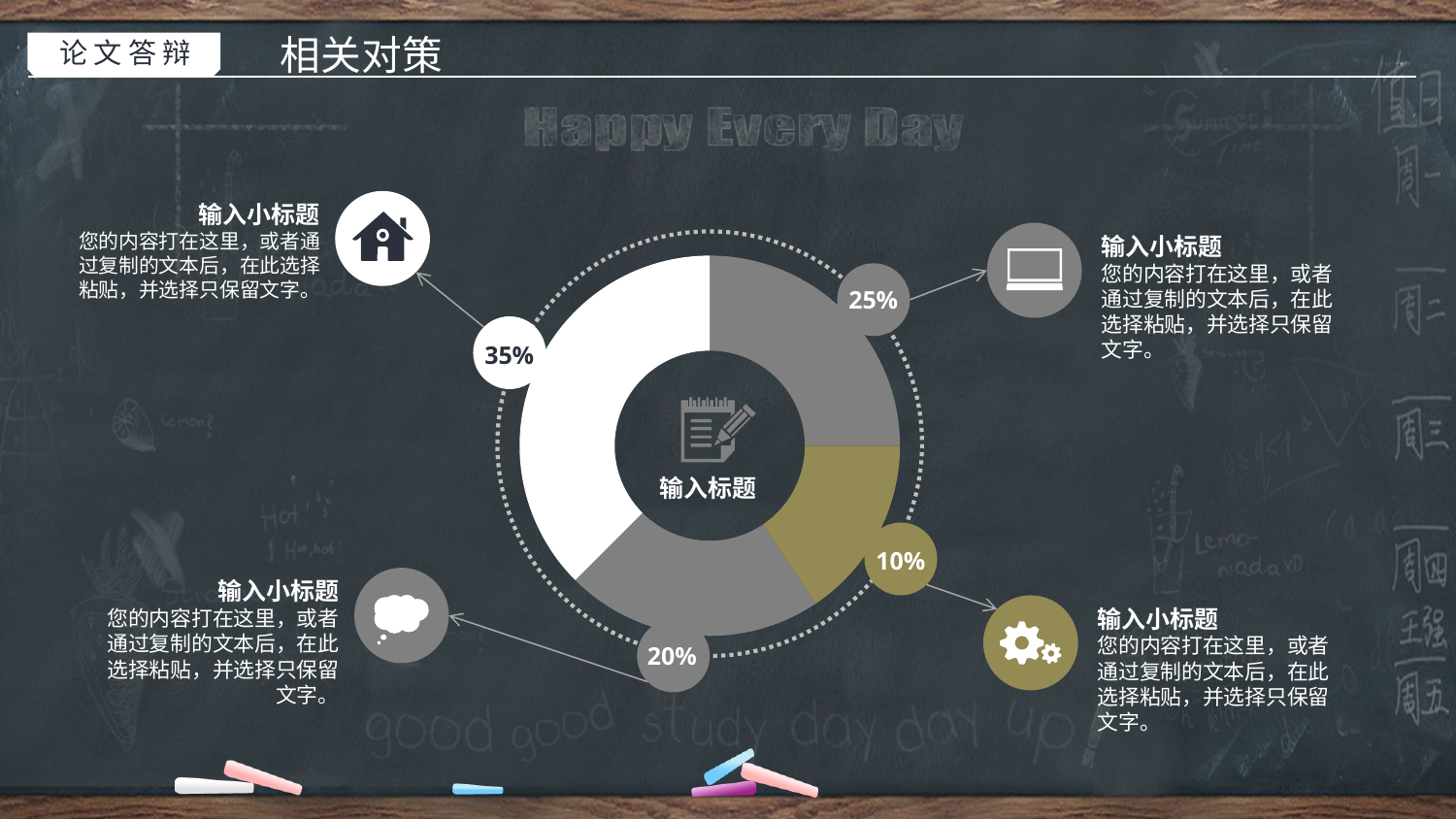
What is the largest percentage shown on the donut chart? 35% What is the total of the four percentages shown on the donut chart? 90% What percentage is labeled on the gray slice at the bottom of the donut chart? 20% What text is written in the center of the donut chart? 输入标题 What kind of chart is shown in the center of the slide? Donut (pie) chart What percentage is labeled on the white slice of the donut chart? 35% What percentage is labeled on the olive/gold slice of the donut chart? 10% Which is larger on the donut chart, the 25% slice or the 20% slice? The 25% slice How many slices does the donut chart have? 4 What is the smallest percentage shown on the donut chart? 10% What is the difference between the largest slice (35%) and the smallest slice (10%) of the donut chart? 25% What percentage is labeled on the light gray slice at the top right of the donut chart? 25%